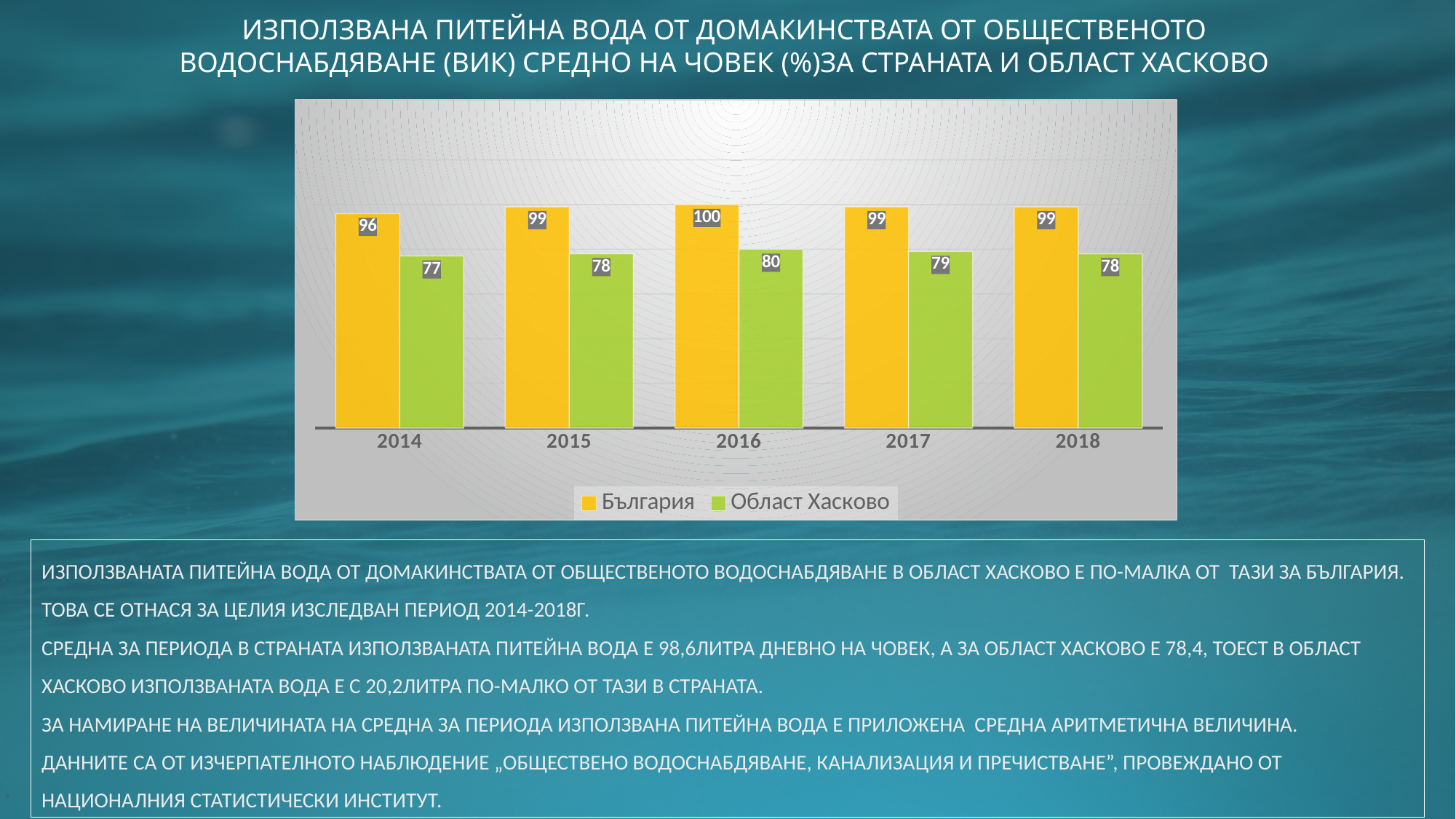
Which is larger in 2015: the value for България or for Област Хасково? България How many series does the legend list? 2 Which colour represents България in the chart? yellow How many years are shown on the x axis? 5 What kind of chart is shown on the slide? bar chart What is the value for Област Хасково in 2014? 77 Does the value for Област Хасково rise or fall from 2016 to 2018? fall In which year is the value for България highest? 2016 What is the value for България in 2016? 100 In which year is the value for Област Хасково lowest? 2014 What is the value for Област Хасково in 2017? 79 What is the difference between the България and Област Хасково values in 2018? 21